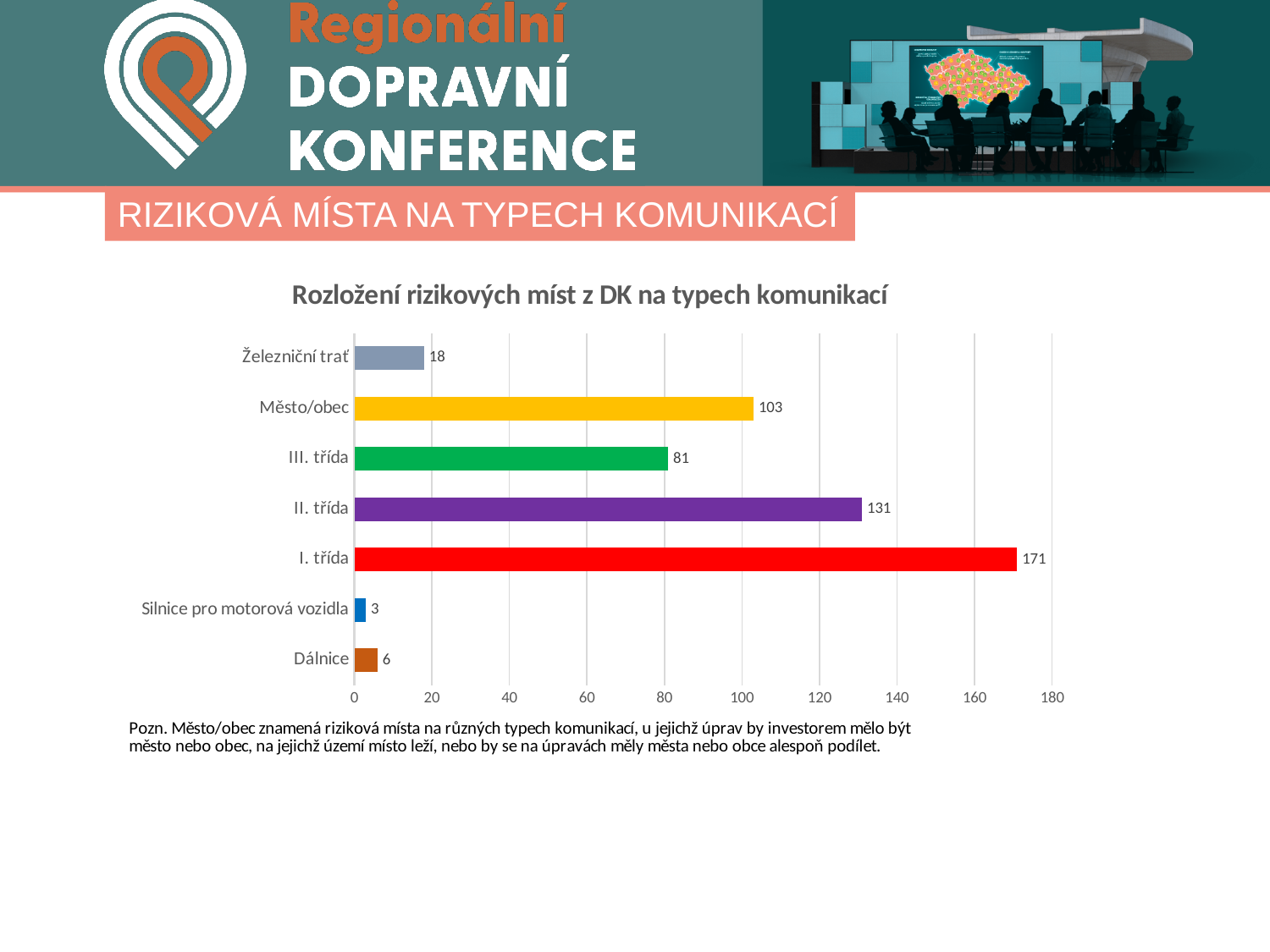
What is the value for I. třída? 171 What is the value for Silnice pro motorová vozidla? 3 What is the difference between the values for Dálnice and Silnice pro motorová vozidla? 3 What kind of chart is shown on the slide? bar chart Which category has the highest value? I. třída Is the value for II. třída greater or less than 120? greater What is the title of the chart? Rozložení rizikových míst z DK na typech komunikací What is the value for Město/obec? 103 How many categories are shown in the chart? 7 What is the difference between the values for I. třída and II. třída? 40 Which is larger, the value for III. třída or the value for Město/obec? Město/obec Which category has the lowest value? Silnice pro motorová vozidla